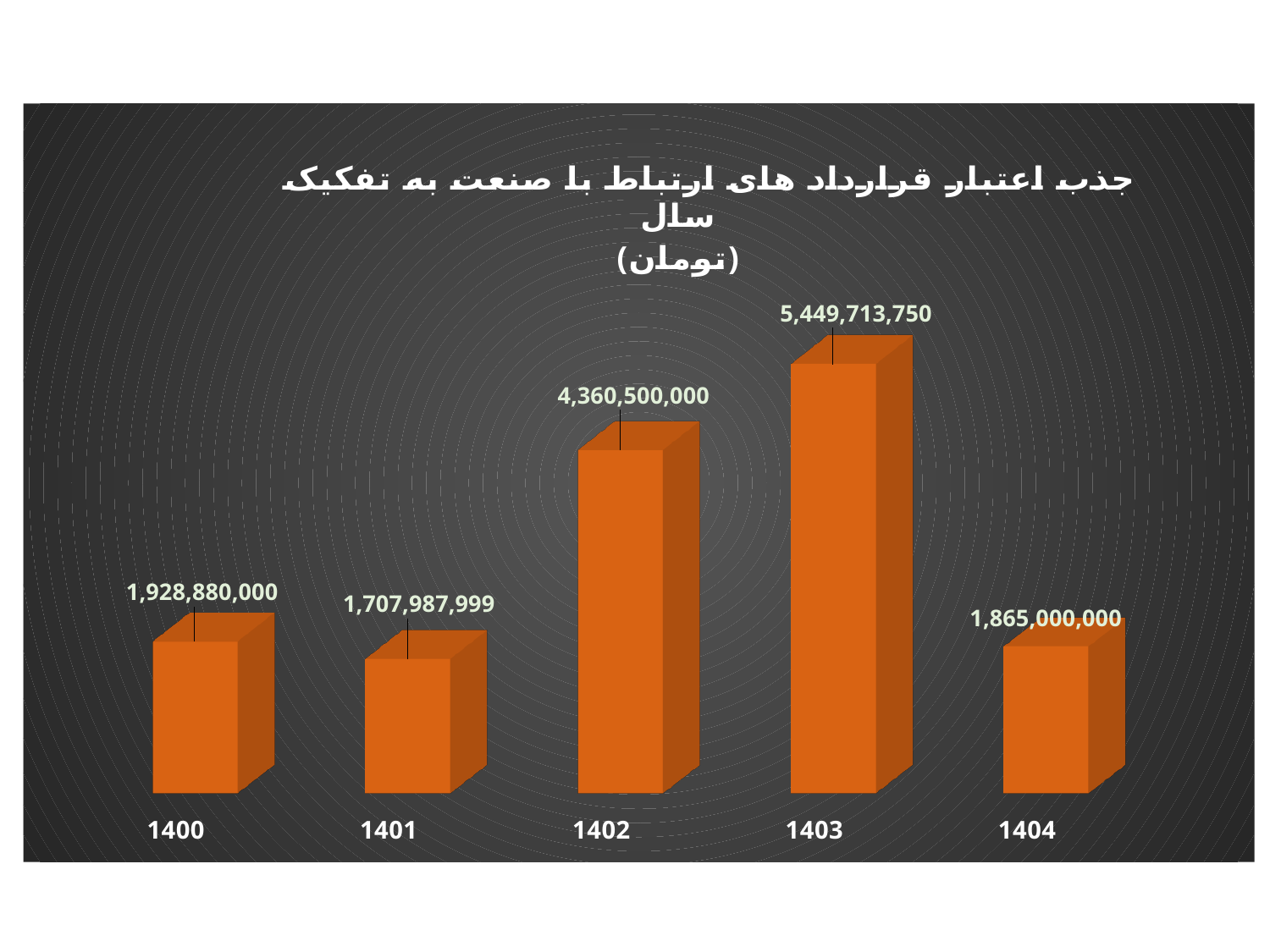
How many years are shown on the x axis? 5 What is the difference between the values for 1403 and 1402? 1,089,213,750 What is the difference between the values for 1400 and 1401? 220,892,001 What is the value for 1402? 4,360,500,000 Which year has the lowest value? 1401 What is the value for 1404? 1,865,000,000 What is the value for 1401? 1,707,987,999 Which year has the highest value? 1403 What is the value for 1403? 5,449,713,750 Which is larger, the value for 1402 or the value for 1404? 1402 What kind of chart is this? bar chart What is the value for 1400? 1,928,880,000